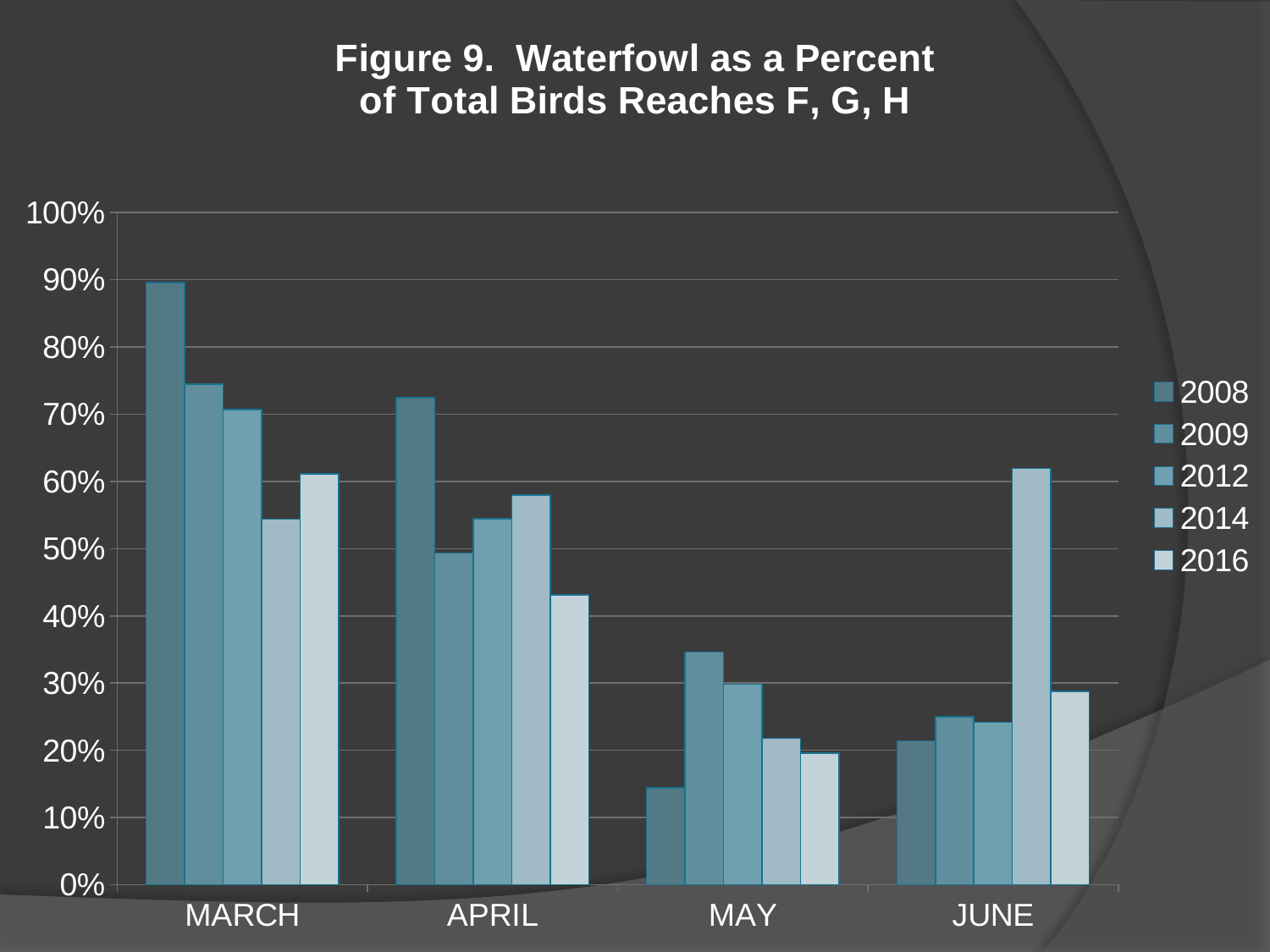
How many series does the legend list? 5 How many months are shown on the x axis? 4 Is the value for 2016 in APRIL greater or less than 50%? less Is the value for 2008 in MARCH greater or less than 80%? greater In JUNE, which series has the higher value, 2014 or 2016? 2014 In which month is the 2008 bar the highest? MARCH In MAY, which series has the higher value, 2008 or 2009? 2009 In which month is the 2008 bar the lowest? MAY What kind of chart is shown on the slide? bar chart Do the values for the 2012 series rise or fall from MARCH to JUNE? fall Is the value for 2014 in JUNE greater or less than 50%? greater What is the title of the chart? Figure 9. Waterfowl as a Percent of Total Birds Reaches F, G, H